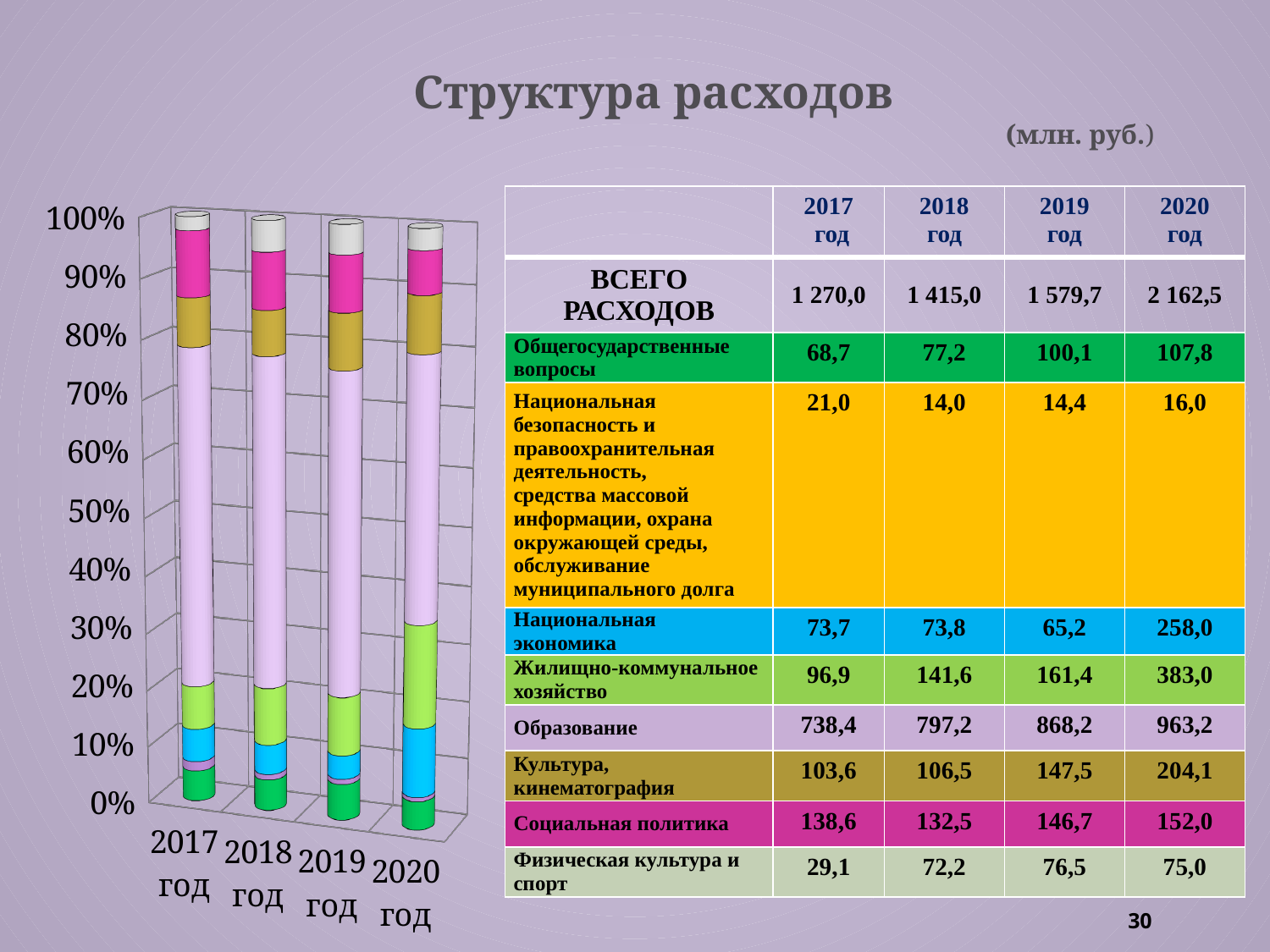
What is the title of the slide's chart? Структура расходов What is the value for Образование in 2019 год? 868,2 What is the difference between total expenditures in 2020 год and 2017 год? 892,5 What is the value of ВСЕГО РАСХОДОВ for 2020 год? 2 162,5 In which year is the value for Национальная безопасность и правоохранительная деятельность the lowest? 2018 год Which year has the highest total expenditures (ВСЕГО РАСХОДОВ)? 2020 год In 2020 год, which is larger: Национальная экономика or Жилищно-коммунальное хозяйство? Жилищно-коммунальное хозяйство What is the value for Национальная экономика in 2020 год? 258,0 How many years (categories) are plotted along the x axis of the chart? 4 Does the share of the light-pink Образование segment in the stacked bars rise or fall from 2017 to 2020? fall In what units are the expenditure values given on the slide? млн. руб. What kind of chart is shown on the left of the slide? stacked bar chart